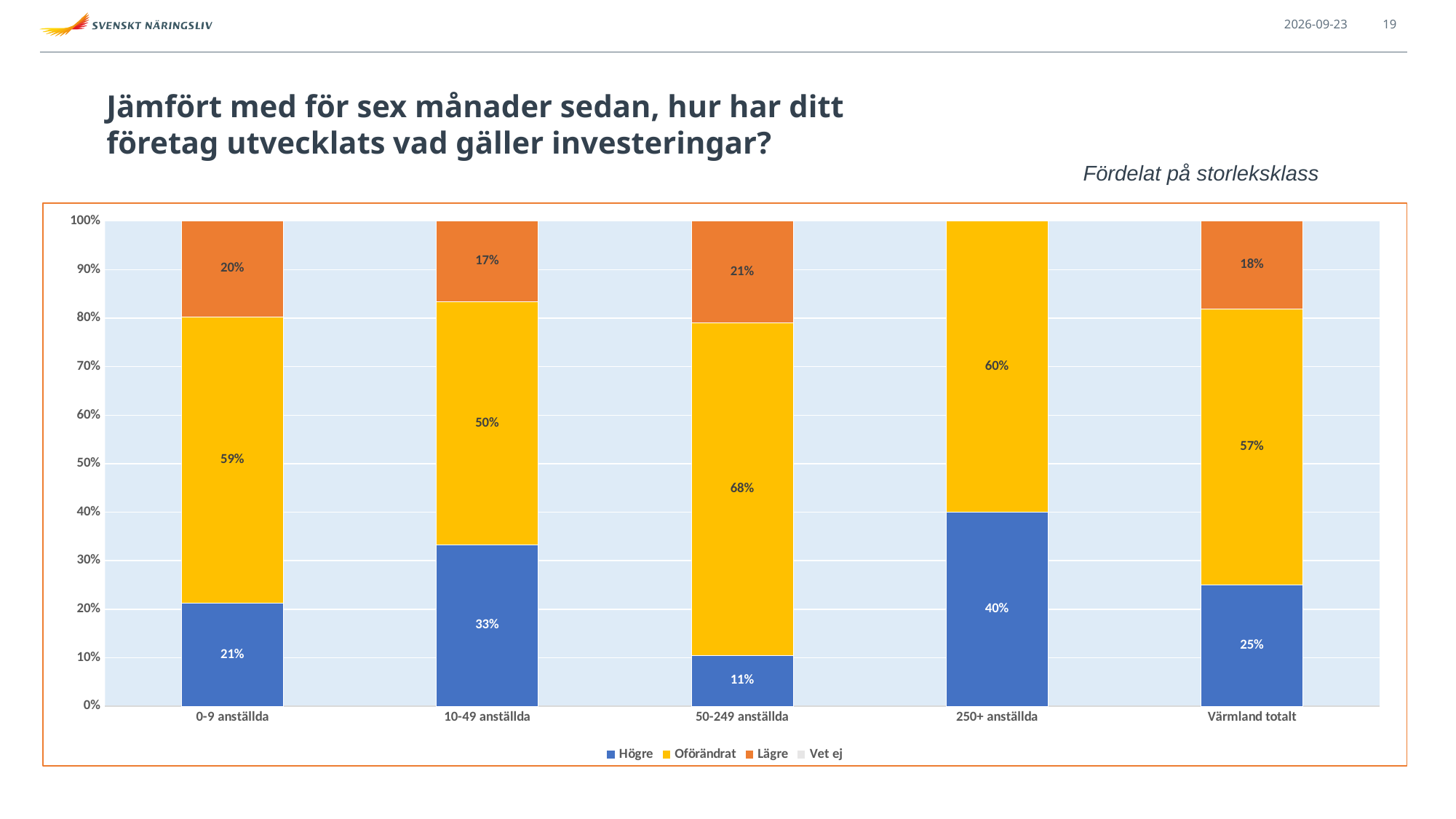
Which is larger, the Lägre value for 0-9 anställda or for 10-49 anställda? 0-9 anställda Which category has the highest Högre value? 250+ anställda What is the Högre value for 250+ anställda? 40% How many categories are shown on the x axis? 5 Which category has the lowest Högre value? 50-249 anställda What is the Oförändrat value for 50-249 anställda? 68% What kind of chart is shown on the slide? Stacked bar chart How many series does the legend list? 4 What is the difference between the Oförändrat values for 50-249 anställda and 10-49 anställda? 18% What is the subtitle shown above the chart on the right? Fördelat på storleksklass What is the Lägre value for Värmland totalt? 18% Which series is shown in blue in the legend? Högre